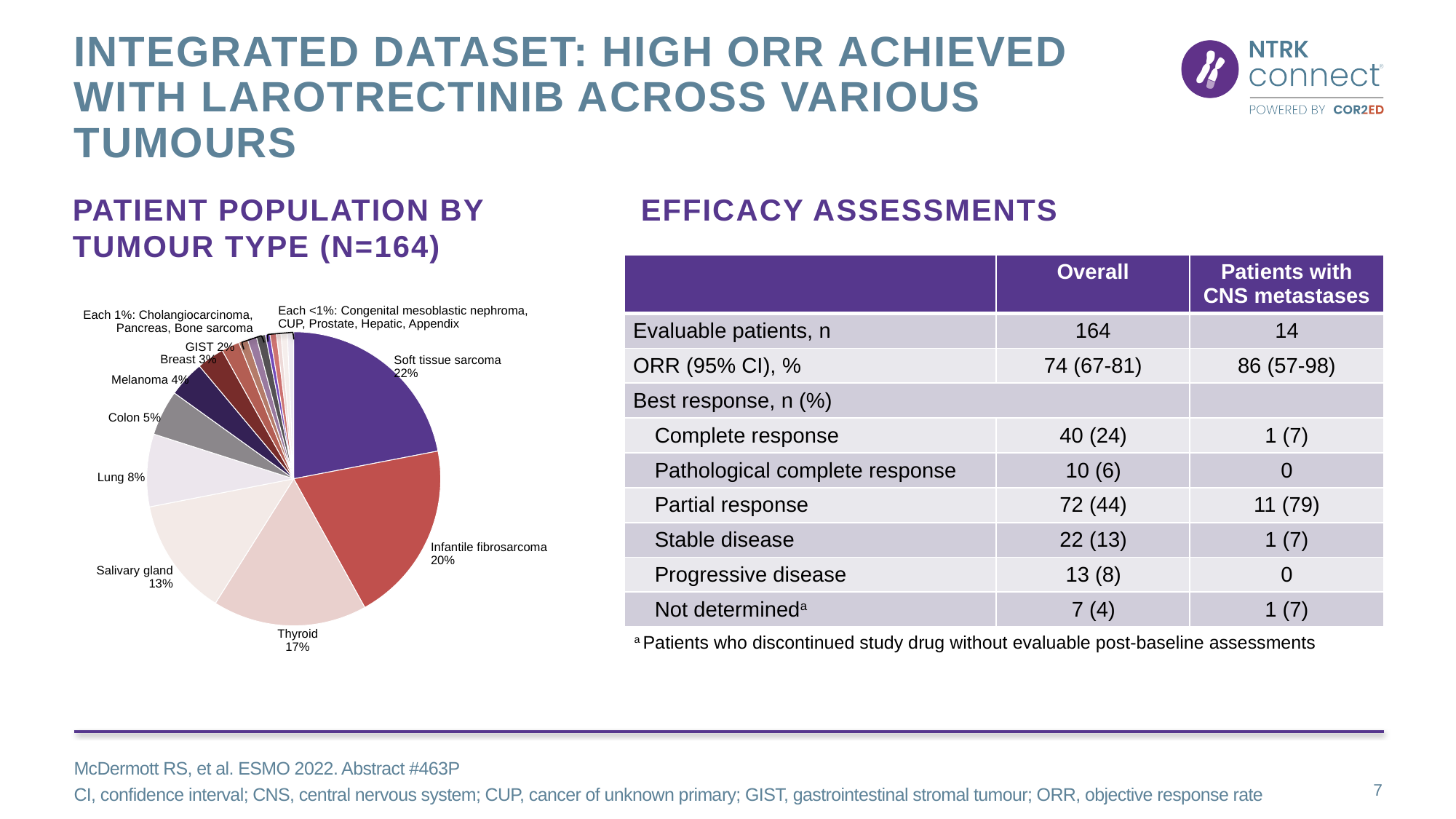
What share of the pie chart is salivary gland? 13% What percentage of patients have melanoma? 4% What percentage of patients have thyroid tumours? 17% What is the total number of patients (N) stated in the pie chart's title? 164 What percentage of patients have breast tumours? 3% By how many percentage points does soft tissue sarcoma exceed infantile fibrosarcoma? 2% What is the difference between the thyroid and salivary gland shares? 4% Which tumour type accounts for the largest share of the patient population? Soft tissue sarcoma What share of the patient population has soft tissue sarcoma? 22% What kind of chart is used to show the patient population by tumour type? Pie chart Which has a larger share of patients, lung or colon? Lung What share of the patient population has GIST? 2%